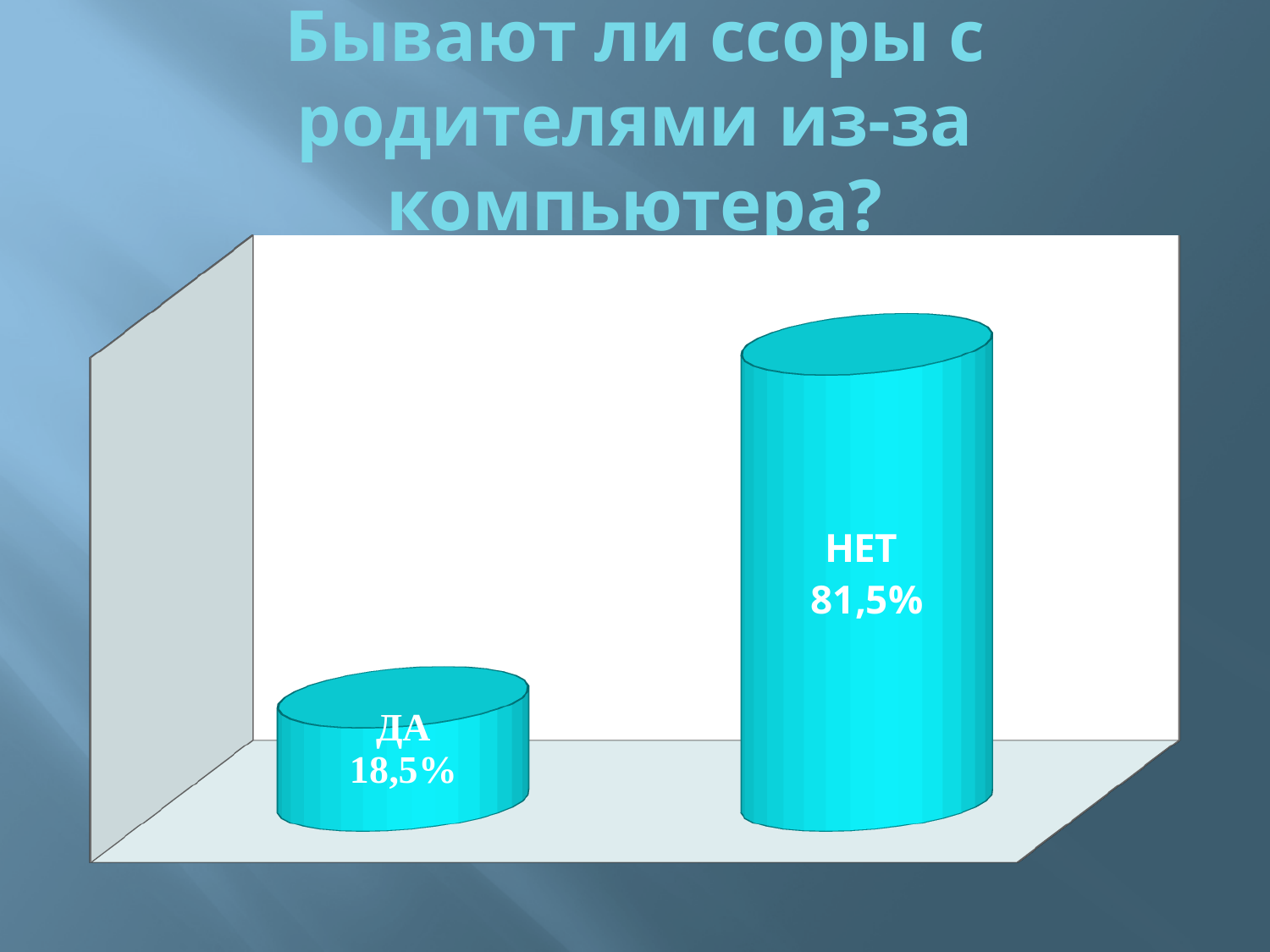
What is the value for НЕТ? 81,5% What is the difference between the values for НЕТ and ДА? 63% Which category has the lowest value? ДА What is the value for ДА? 18,5% What kind of chart is shown on the slide? bar chart What is the total of the two values shown in the chart? 100% Which is larger, the value for ДА or the value for НЕТ? НЕТ What is the title of the slide? Бывают ли ссоры с родителями из-за компьютера? What colour are the bars in the chart? cyan How many categories are shown in the chart? 2 Which category has the highest value? НЕТ